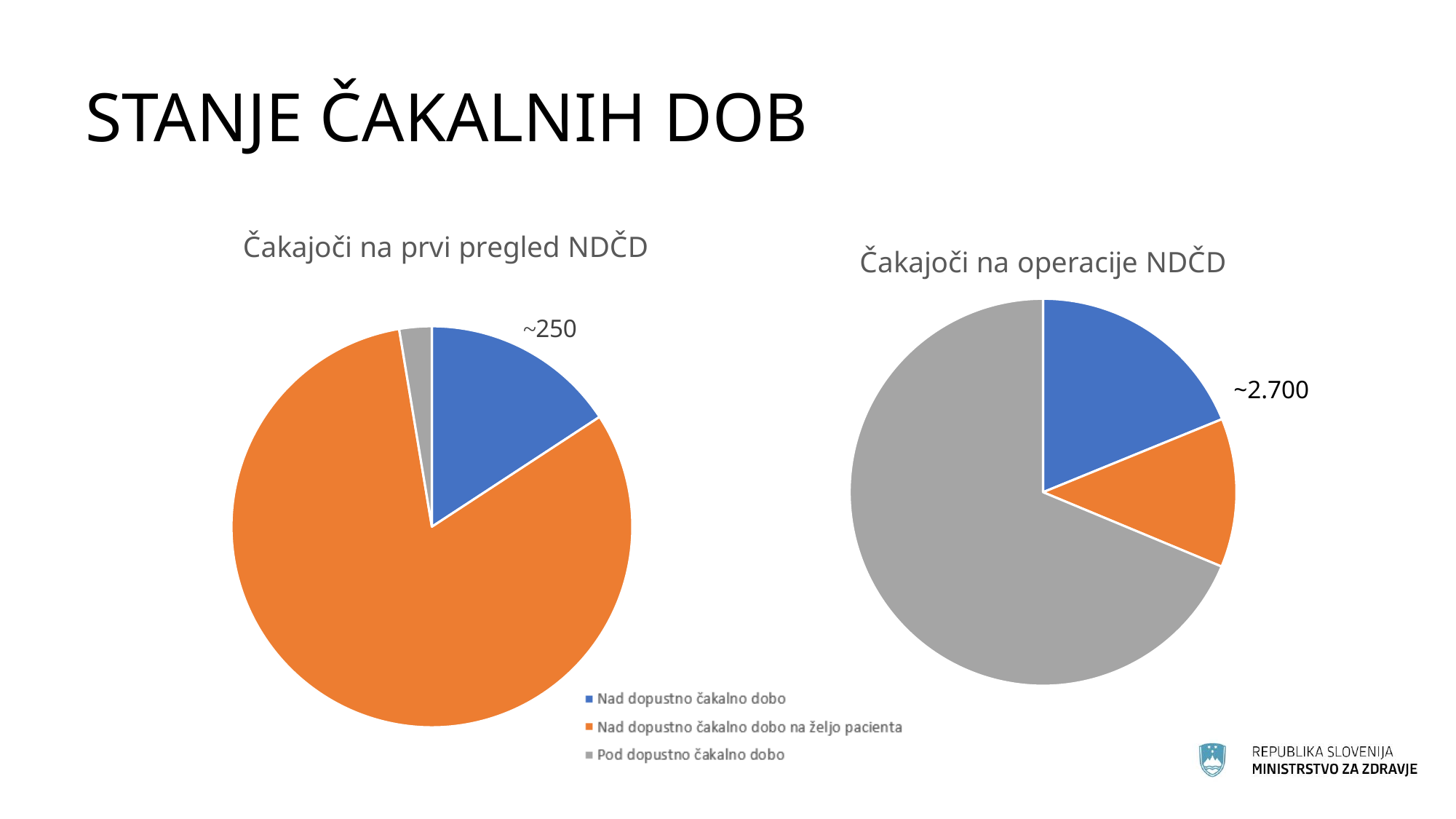
What colour represents "Pod dopustno čakalno dobo" in the charts? grey In the chart "Čakajoči na prvi pregled NDČD", which category has the smallest slice? Pod dopustno čakalno dobo In the chart "Čakajoči na operacije NDČD", which slice is larger: "Nad dopustno čakalno dobo" or "Nad dopustno čakalno dobo na željo pacienta"? Nad dopustno čakalno dobo In the chart "Čakajoči na operacije NDČD", which category has the smallest slice? Nad dopustno čakalno dobo na željo pacienta In the chart "Čakajoči na operacije NDČD", which category has the largest slice? Pod dopustno čakalno dobo How many categories does the legend list? 3 In the chart "Čakajoči na prvi pregled NDČD", which category has the largest slice? Nad dopustno čakalno dobo na željo pacienta What is the title of the chart on the left of the slide? Čakajoči na prvi pregled NDČD How many slices does the chart "Čakajoči na prvi pregled NDČD" have? 3 What kind of chart is the chart titled "Čakajoči na prvi pregled NDČD"? pie chart What kind of chart is the chart titled "Čakajoči na operacije NDČD"? pie chart In the chart "Čakajoči na prvi pregled NDČD", which slice is larger: "Nad dopustno čakalno dobo" or "Pod dopustno čakalno dobo"? Nad dopustno čakalno dobo